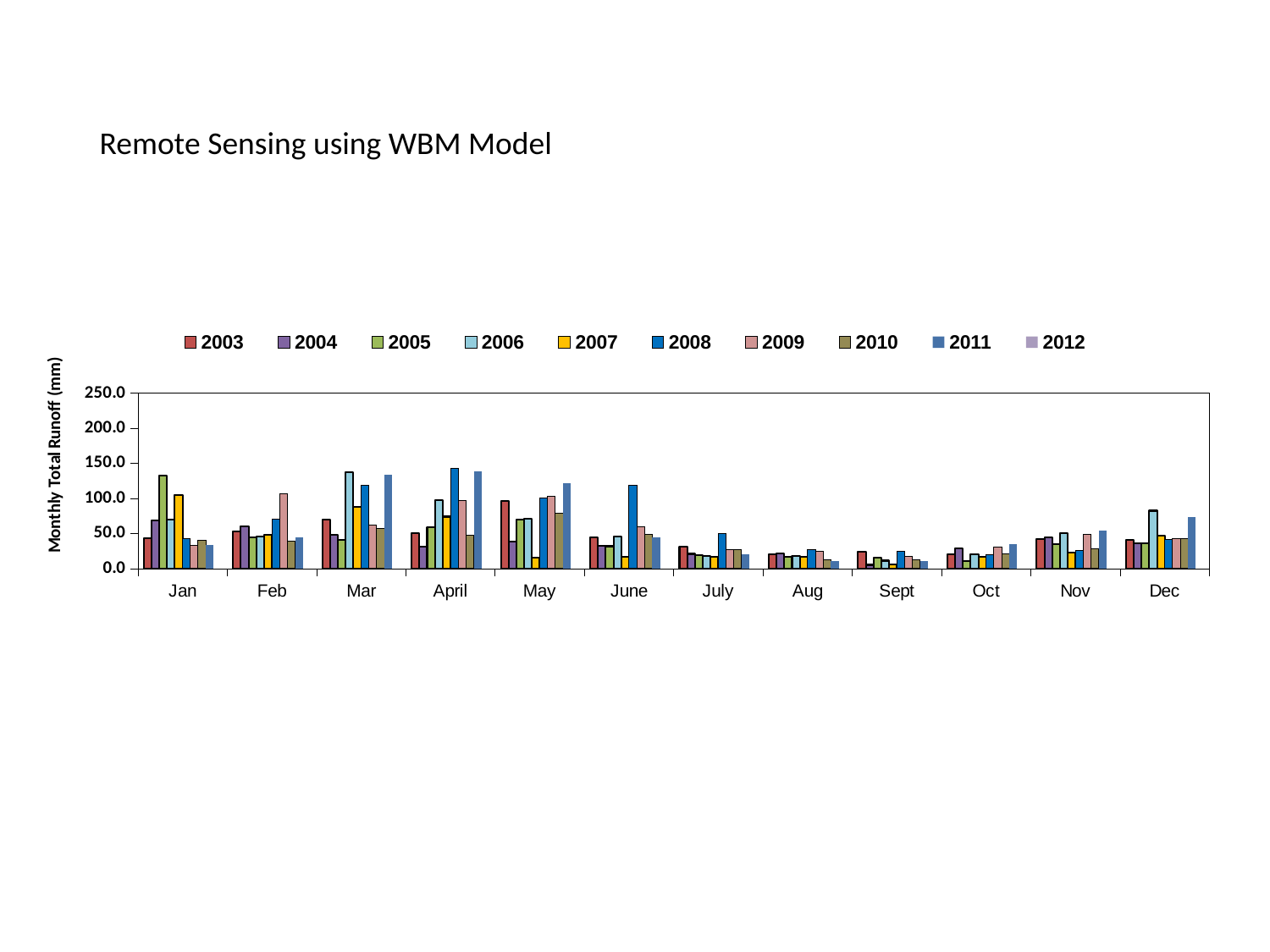
Is the value for 2008 in April greater or less than 100? greater Which is larger for 2008: the value in June or the value in July? June Which year has the highest value in June? 2008 Which year has the highest value in Jan? 2005 What is the label on the vertical axis? Monthly Total Runoff (mm) Do the values for 2008 rise or fall from June to Sept? fall Is the value for 2003 in Aug greater or less than 50? less Is the value for 2006 in Mar greater or less than 100? greater What kind of chart is shown on the slide? bar chart How many series (years) does the legend list? 10 How many months (categories) are shown along the x axis? 12